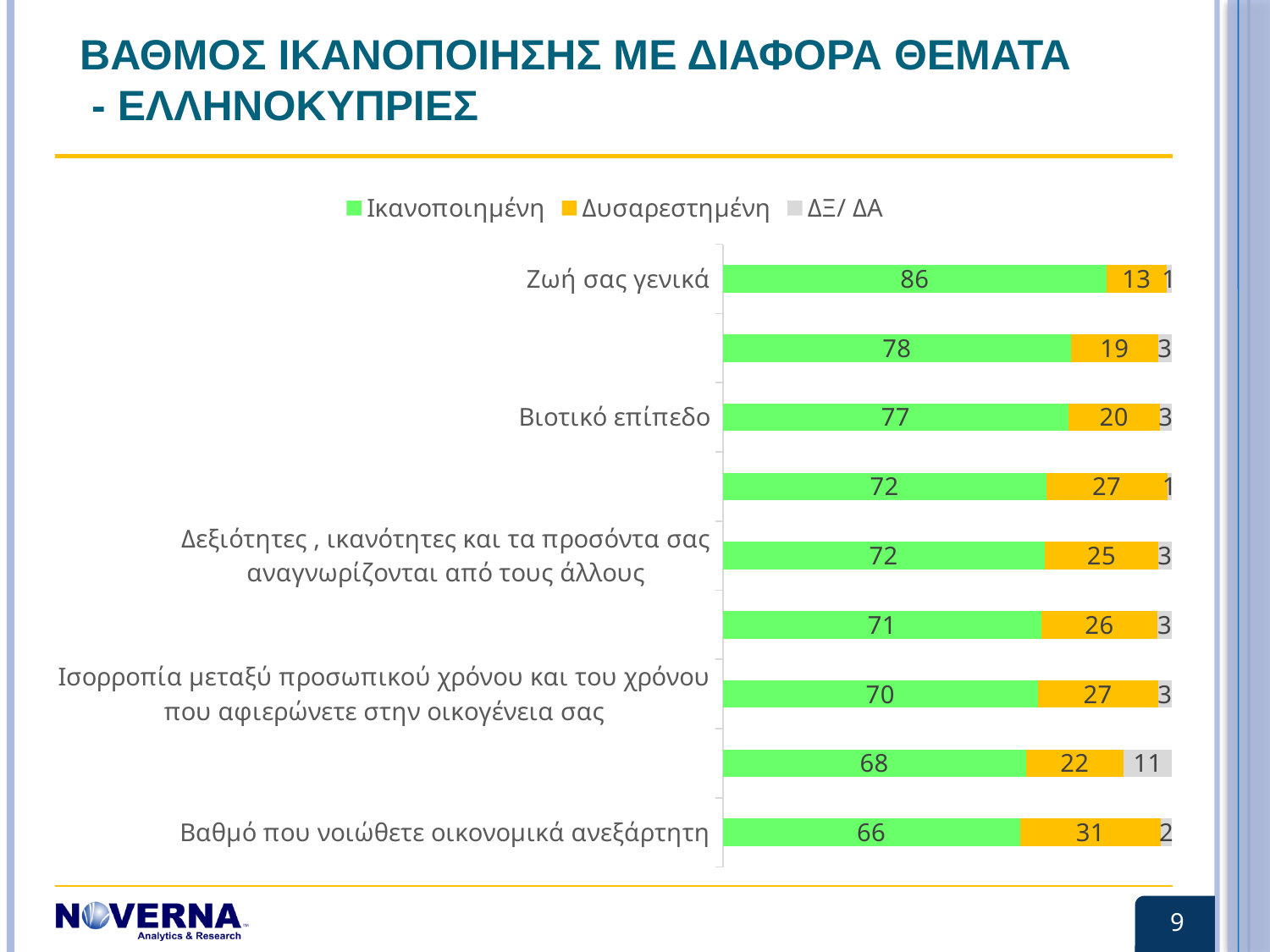
Which category has the lowest Ικανοποιημένη value? Βαθμό που νοιώθετε οικονομικά ανεξάρτητη Which category has the highest Ικανοποιημένη value? Ζωή σας γενικά How many bars are plotted in the chart? 9 What is the Δυσαρεστημένη value for Βαθμό που νοιώθετε οικονομικά ανεξάρτητη? 31 What type of chart is shown on the slide? Stacked bar chart What is the difference between the Ικανοποιημένη values for Ζωή σας γενικά and Βαθμό που νοιώθετε οικονομικά ανεξάρτητη? 20 How many series does the legend list? 3 Which has the larger Ικανοποιημένη value, Βιοτικό επίπεδο or Ισορροπία μεταξύ προσωπικού χρόνου και του χρόνου που αφιερώνετε στην οικογένεια σας? Βιοτικό επίπεδο What is the ΔΞ/ΔΑ value for Βιοτικό επίπεδο? 3 What is the Ικανοποιημένη value for Ζωή σας γενικά? 86 What is the total of the stacked bar for Ζωή σας γενικά? 100 What is the Δυσαρεστημένη value for Ισορροπία μεταξύ προσωπικού χρόνου και του χρόνου που αφιερώνετε στην οικογένεια σας? 27